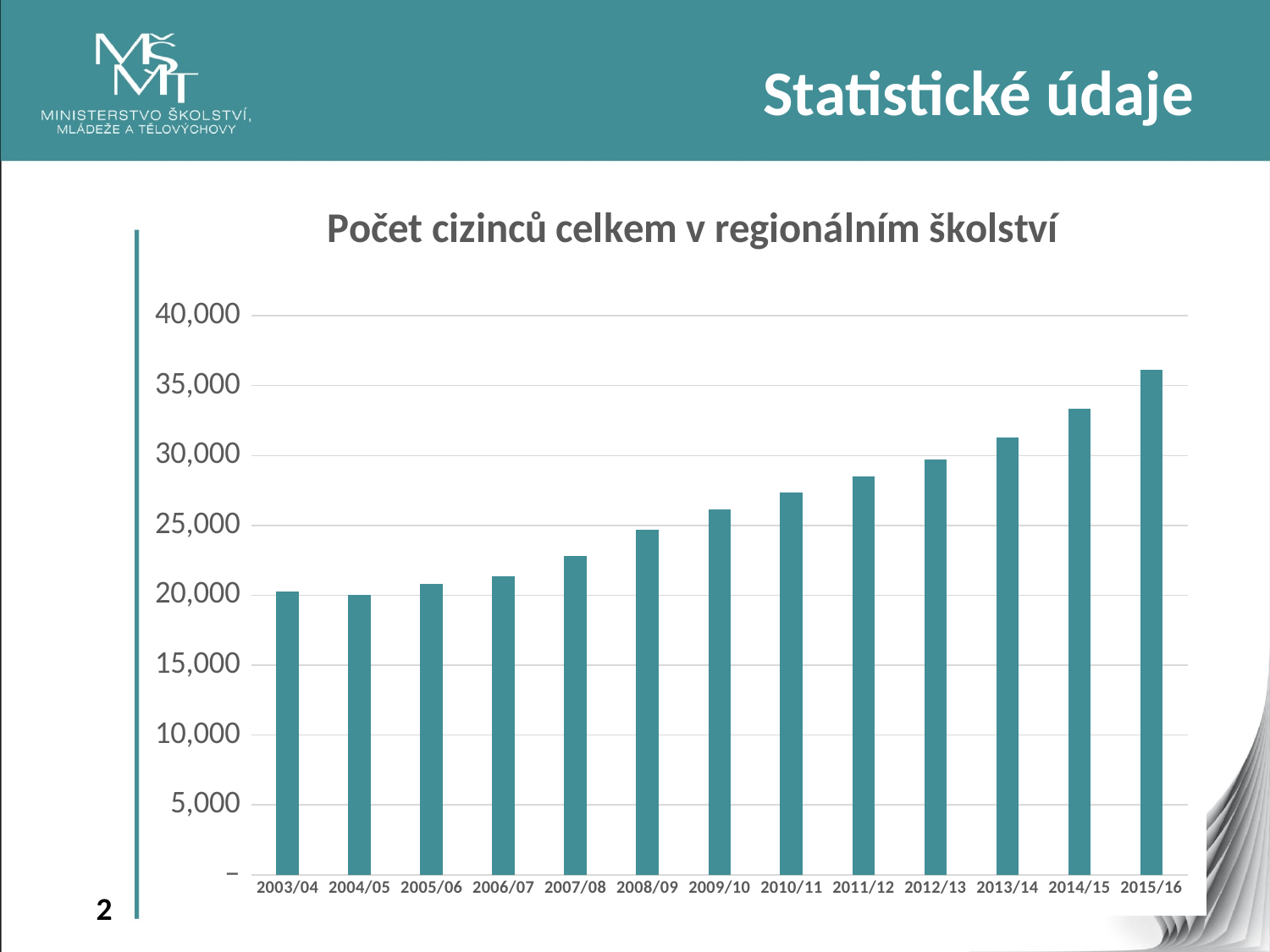
Is the value for 2010/11 greater or less than 25,000? greater Is the value for 2013/14 greater or less than 30,000? greater Is the value for 2007/08 greater or less than 25,000? less Which is larger, the value for 2003/04 or the value for 2015/16? 2015/16 What kind of chart is shown on the slide? bar chart Do the values generally rise or fall from 2003/04 to 2015/16? rise Which is larger, the value for 2009/10 or the value for 2006/07? 2009/10 What is the title of the chart? Počet cizinců celkem v regionálním školství How many school years are shown on the x axis of the chart? 13 Which school year has the highest value in the chart? 2015/16